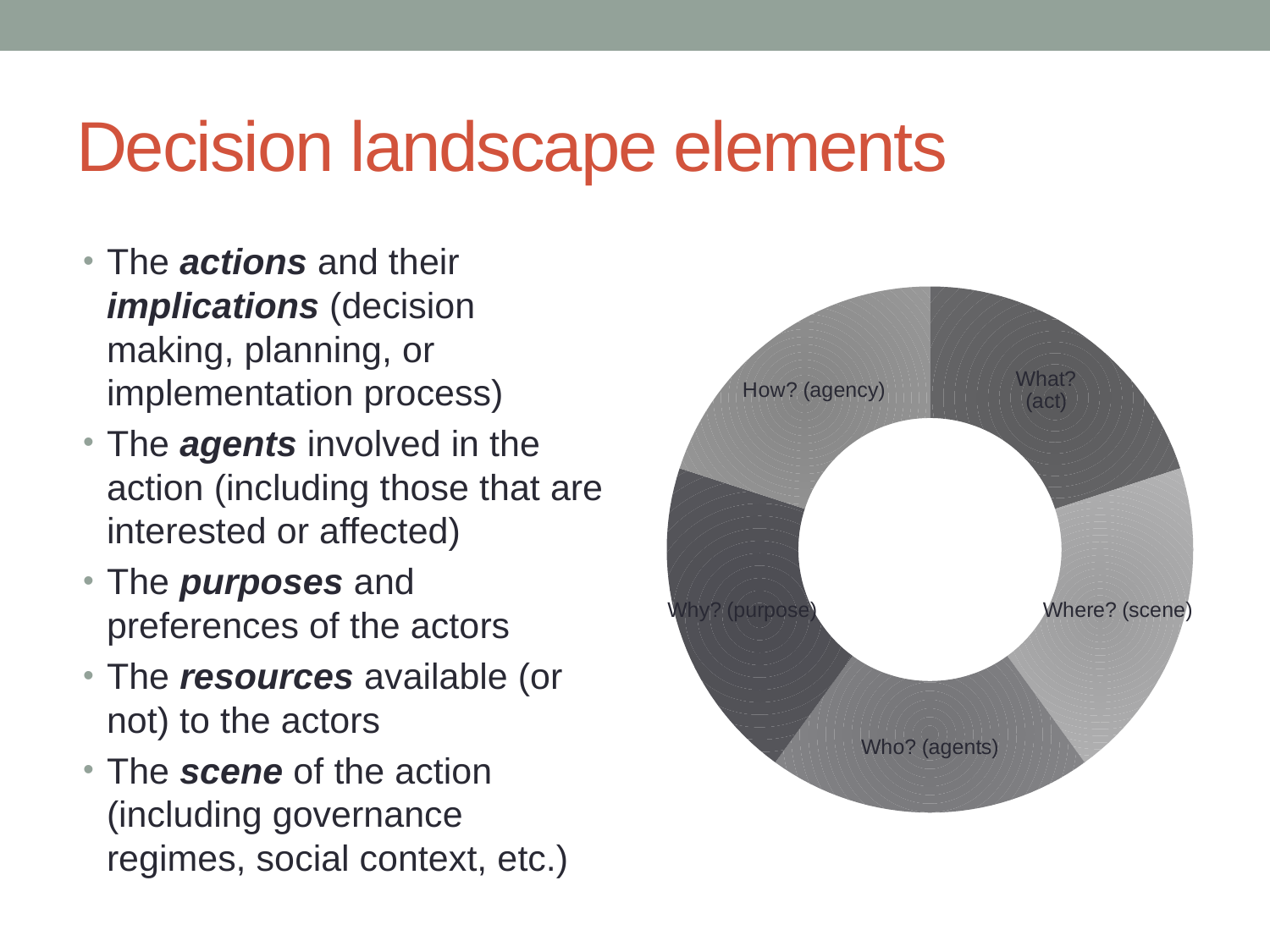
How many segments does the doughnut chart have? 5 What label appears on the bottom segment of the doughnut chart? Who? (agents) Which question word is paired with 'agency' in the doughnut chart? How? What is the label of the segment at the top right of the doughnut chart? What? (act) Which segment of the doughnut chart is labelled with the word 'act'? What? (act) Which segment of the doughnut chart is labelled 'Where? (scene)'? The segment on the right side What label appears on the top-left segment of the doughnut chart? How? (agency) What label appears on the left segment of the doughnut chart? Why? (purpose) What kind of chart is shown on the slide? Doughnut chart Which question word is paired with 'purpose' in the doughnut chart? Why?